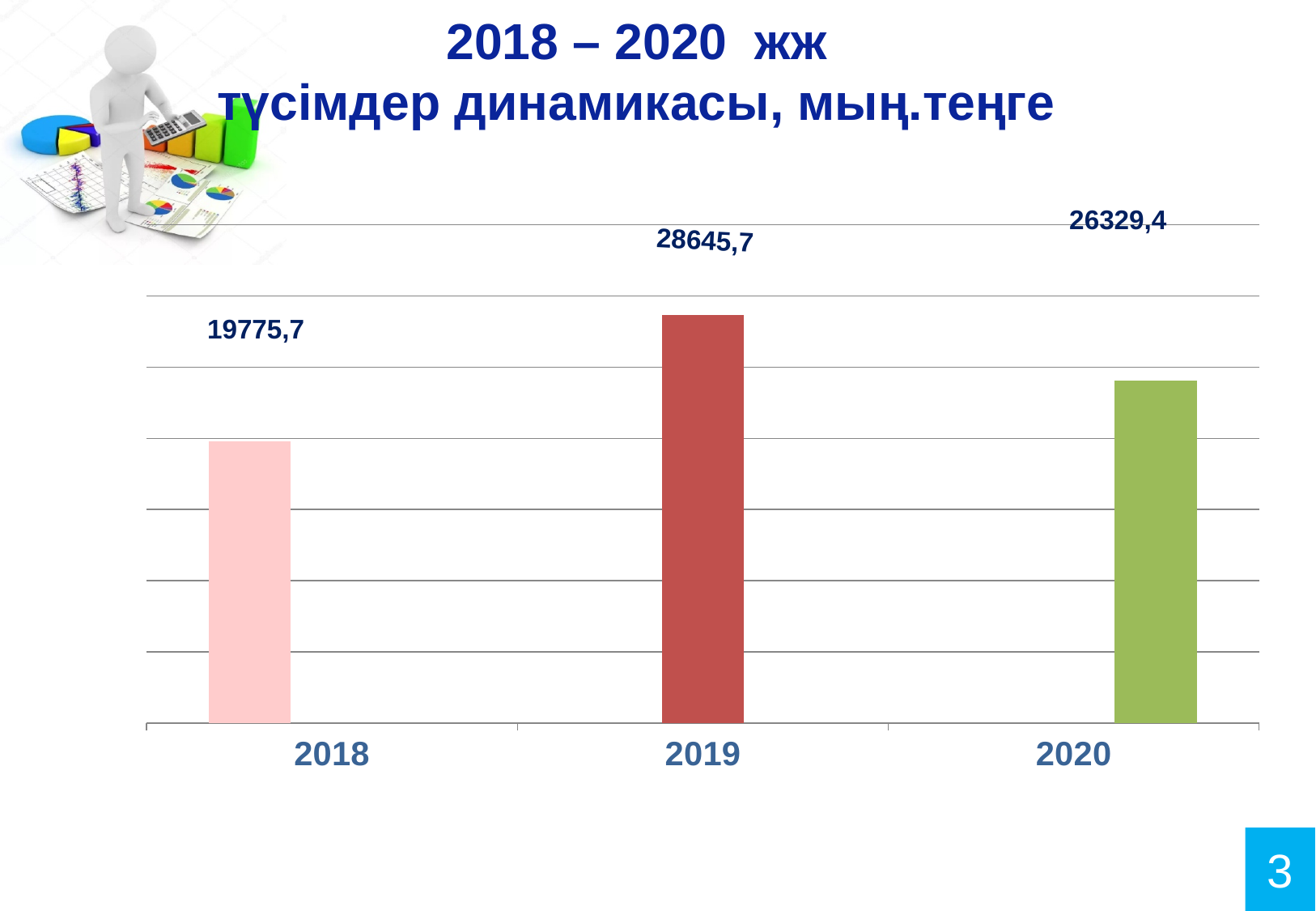
Which year has the highest value? 2019 What kind of chart is shown on the slide? Bar chart Do the values rise or fall from 2019 to 2020? Fall Which year has the lowest value? 2018 What is the difference between the values for 2019 and 2020? 2316,3 What colour is the bar for 2020? Green How many years are shown on the chart? 3 What is the difference between the values for 2019 and 2018? 8870,0 What is the value for 2020? 26329,4 What is the value for 2018? 19775,7 Which is larger, the value for 2020 or the value for 2018? 2020 What is the value for 2019? 28645,7